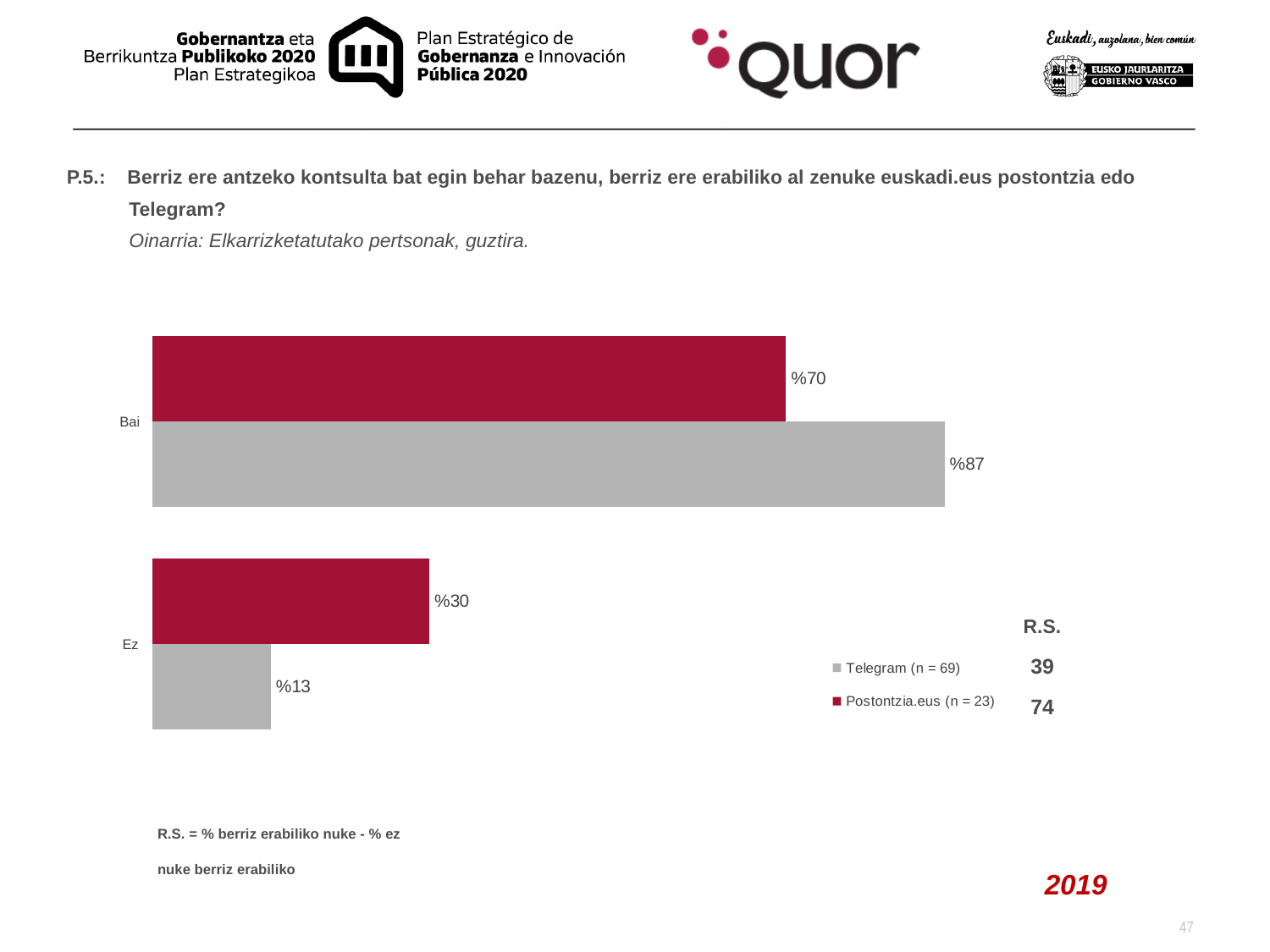
What is the difference between the Telegram and Postontzia.eus values in the Bai category? 17 What is the value for Postontzia.eus in the Bai category? %70 How many series does the legend list? 2 Which series has the higher value in the Ez category? Postontzia.eus What is the value for Postontzia.eus in the Ez category? %30 What kind of chart is shown on the slide? Bar chart What is the value for Telegram in the Bai category? %87 What is the difference between the Postontzia.eus and Telegram values in the Ez category? 17 Which series has the higher value in the Bai category? Telegram What is the value for Telegram in the Ez category? %13 How many categories are shown on the chart? 2 What is the sample size (n) shown in the legend for Telegram? 69